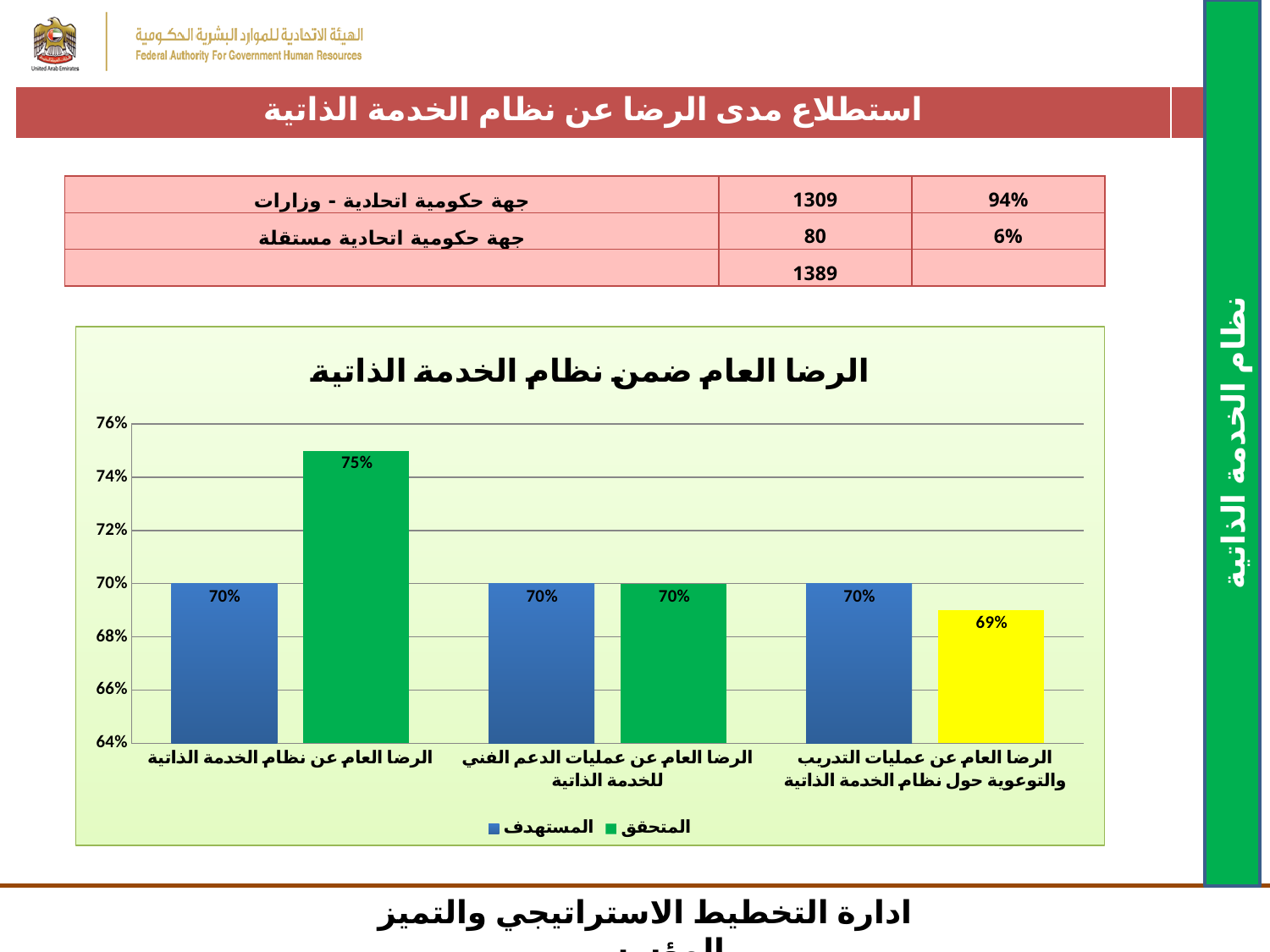
What type of chart is shown on the slide? bar chart Which category has the highest achieved (المتحقق) value? الرضا العام عن نظام الخدمة الذاتية How many categories are shown on the x axis of the chart? 3 Is the achieved value for الرضا العام عن نظام الخدمة الذاتية greater or less than 72%? greater For الرضا العام عن عمليات التدريب والتوعوية حول نظام الخدمة الذاتية, which is larger: the target (المستهدف) or the achieved value? المستهدف What is the value of the yellow bar for الرضا العام عن عمليات التدريب والتوعوية حول نظام الخدمة الذاتية? 69% Which series is shown in blue in the chart legend? المستهدف What is the title of the chart? الرضا العام ضمن نظام الخدمة الذاتية What is the difference between the achieved value and the target value for الرضا العام عن نظام الخدمة الذاتية? 5% How many series does the chart legend list? 2 What is the achieved (المتحقق) value for الرضا العام عن نظام الخدمة الذاتية? 75% What is the target (المستهدف) value for الرضا العام عن عمليات الدعم الفني للخدمة الذاتية? 70%